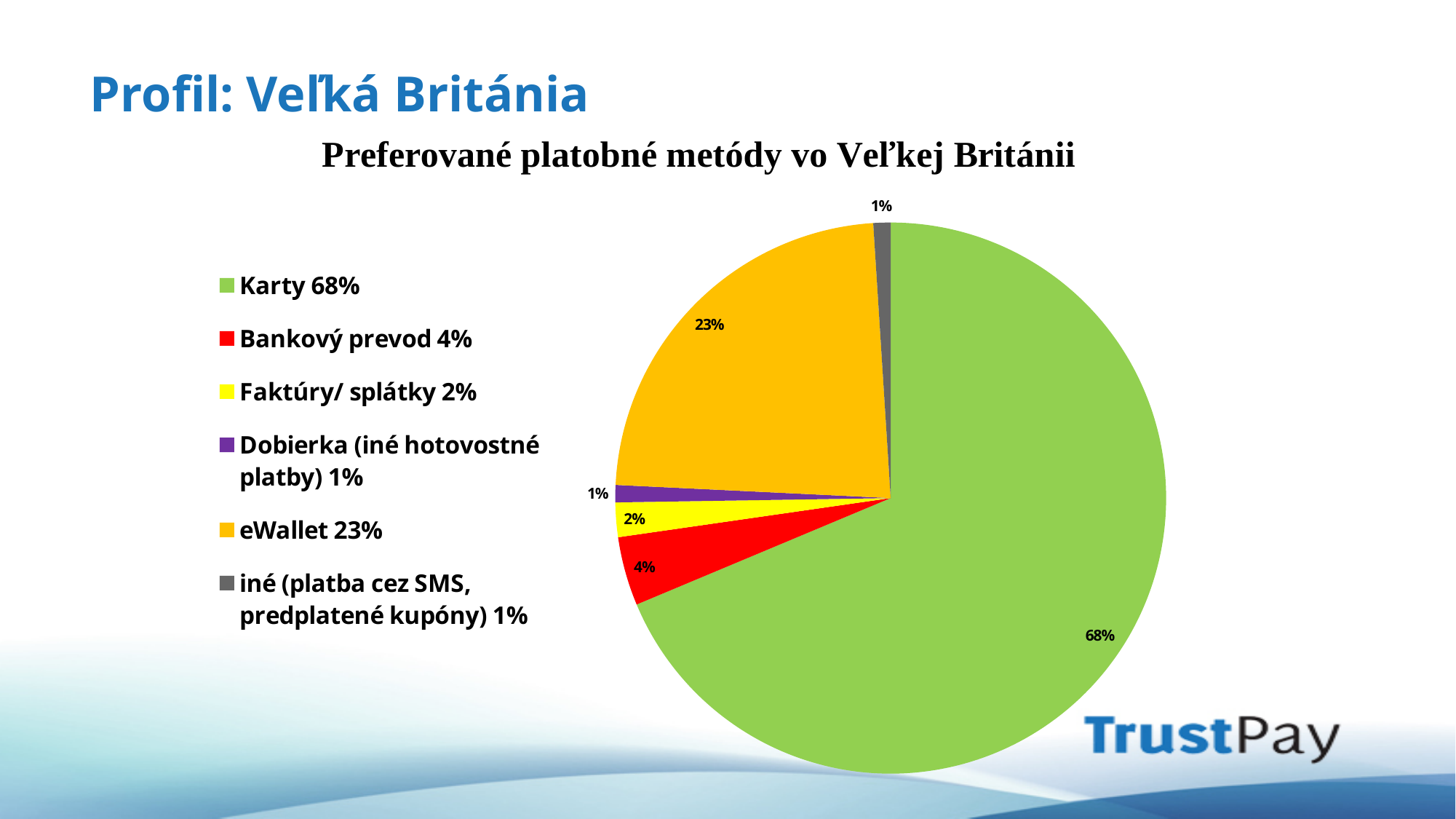
How many categories does the pie chart show? 6 What colour is the eWallet slice? Orange What is the combined share of Bankový prevod and Faktúry/ splátky? 6% What is the value for Bankový prevod? 4% What kind of chart is shown on the slide? Pie chart What is the value for eWallet? 23% What is the difference between the Karty and eWallet shares? 45% What share of the pie does Karty have? 68% Which category has the largest slice of the pie? Karty What is the value for Faktúry/ splátky? 2% What is the title of the chart? Preferované platobné metódy vo Veľkej Británii Which is larger, Bankový prevod or Faktúry/ splátky? Bankový prevod